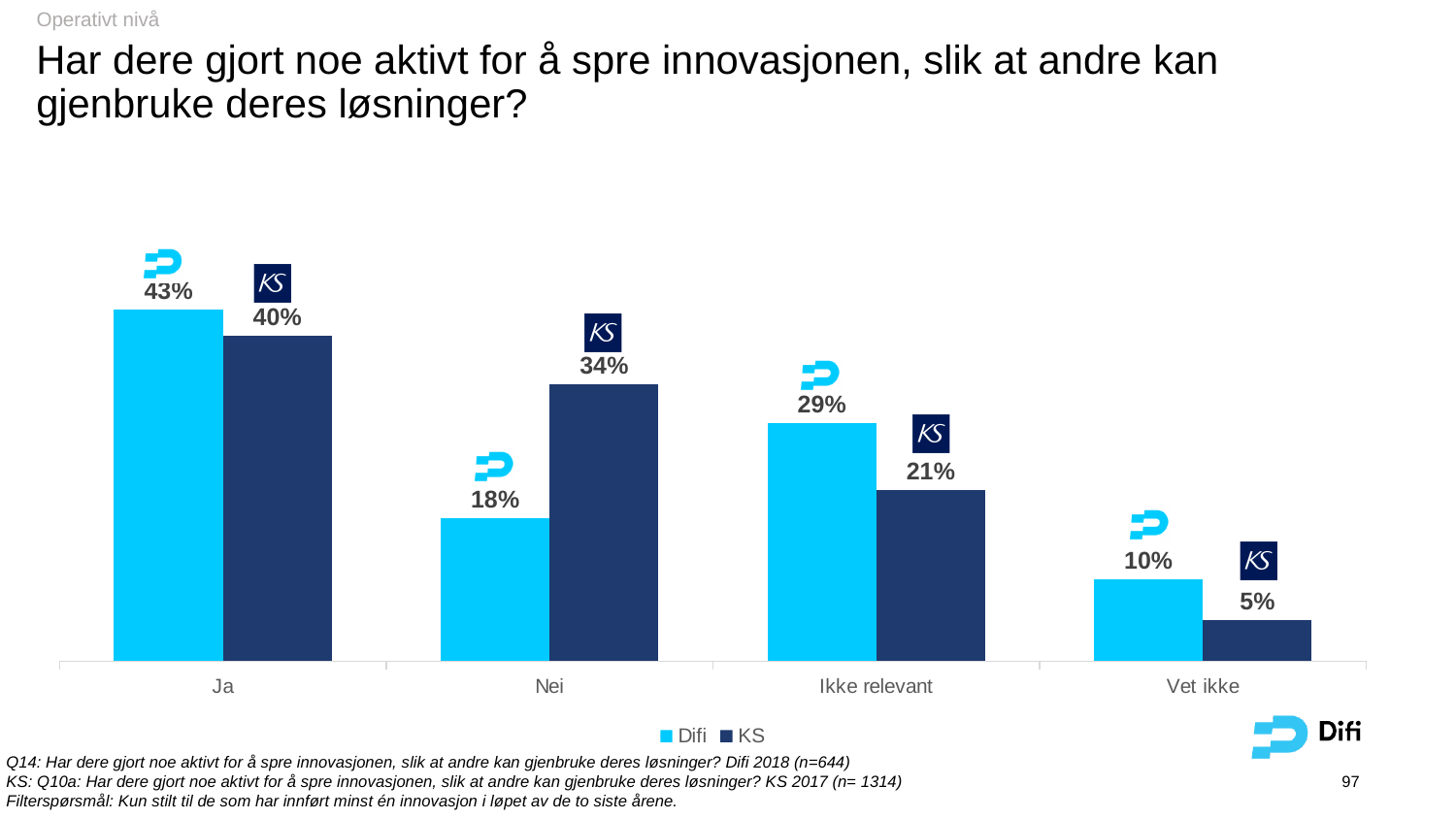
How many series does the legend list? 2 What is the Difi value for "Ja"? 43% What kind of chart is shown on the slide? Bar chart Which category has the highest Difi value? Ja How many categories are shown on the x axis? 4 What is the difference between the Difi values for "Ja" and "Nei"? 25% What is the KS value for "Nei"? 34% Which series is shown in light blue in the legend? Difi What is the KS value for "Vet ikke"? 5% For "Nei", which series has the larger value, Difi or KS? KS What is the difference between the Difi and KS values for "Ikke relevant"? 8% Which category has the lowest KS value? Vet ikke